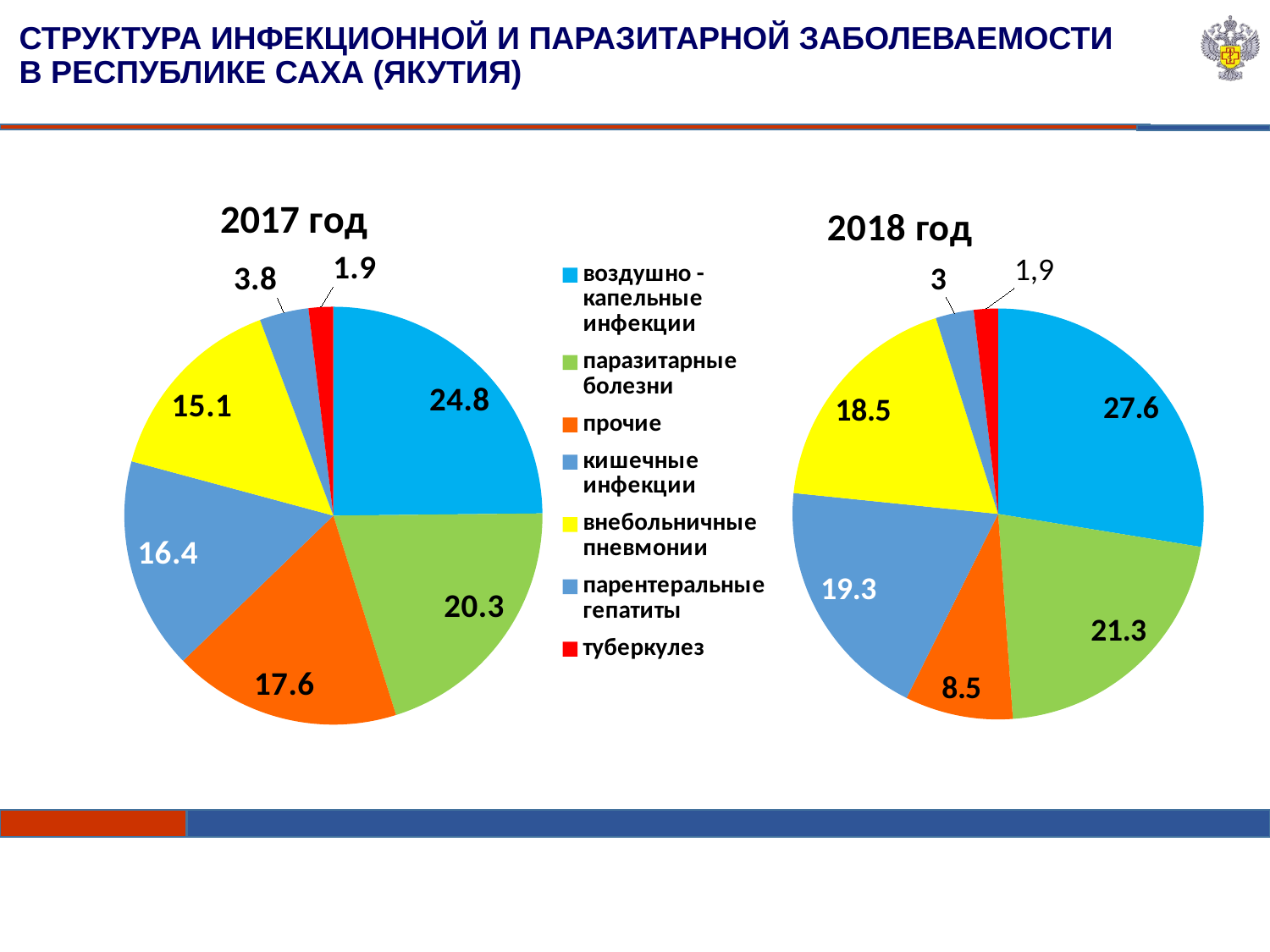
In the 2018 год chart, which is larger: кишечные инфекции or прочие? кишечные инфекции What kind of chart is the 2018 год chart? pie chart In the 2017 год chart, which category has the smallest slice? туберкулез In the 2017 год chart, what is the value for парентеральные гепатиты? 3.8 In the 2017 год chart, what is the difference between the values for воздушно-капельные инфекции and паразитарные болезни? 4.5 In the 2018 год chart, what is the value for внебольничные пневмонии? 18.5 How many slices does the 2017 год chart have? 7 In the 2017 год chart, what is the value for воздушно-капельные инфекции? 24.8 In the 2018 год chart, what is the value for прочие? 8.5 In the 2018 год chart, what is the value for туберкулез? 1,9 Which colour represents туберкулез in the legend? red In the 2018 год chart, which category has the largest slice? воздушно-капельные инфекции